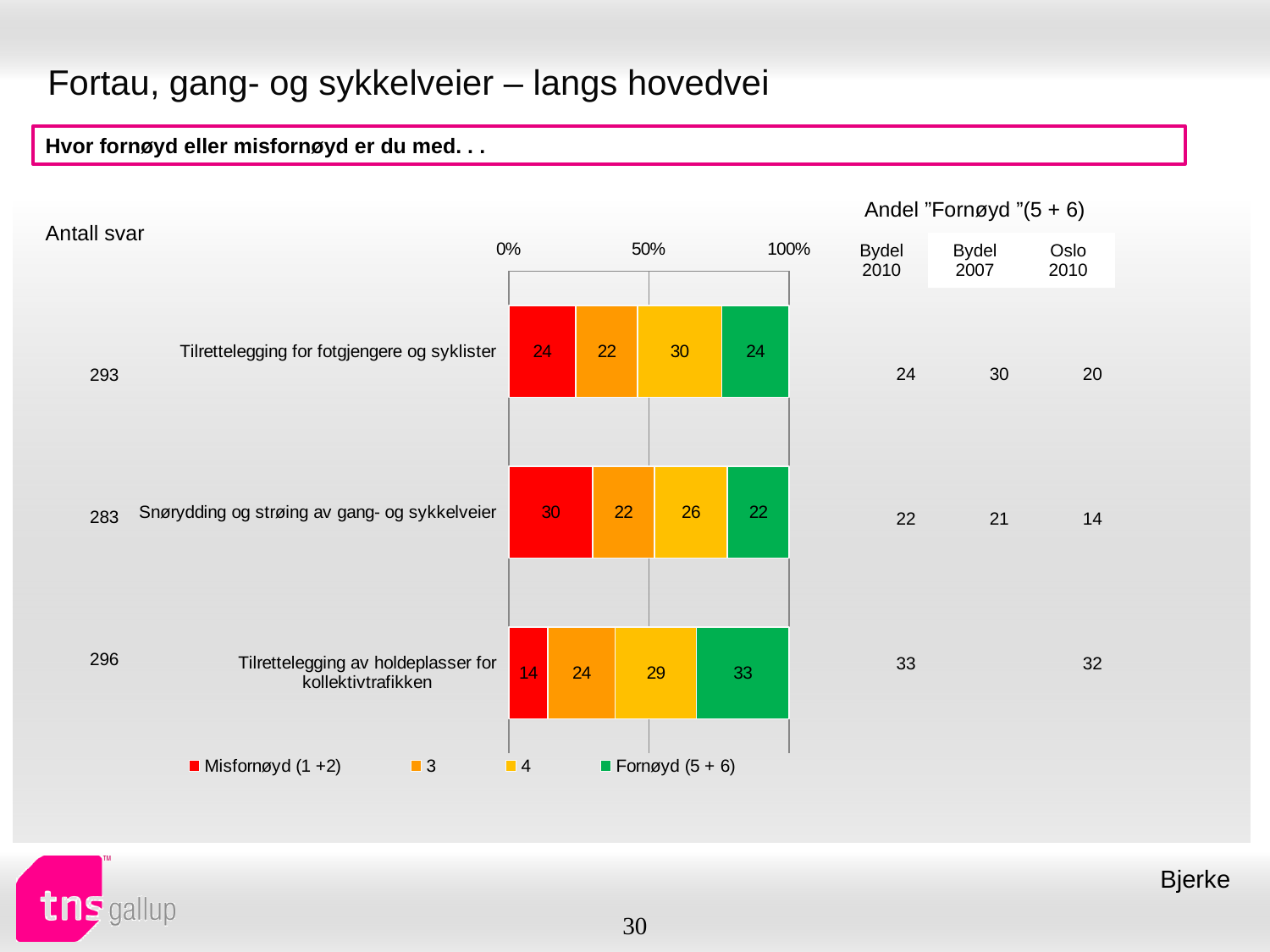
Which category has the highest 'Fornøyd (5 + 6)' value? Tilrettelegging av holdeplasser for kollektivtrafikken What is the difference between the 'Misfornøyd (1 +2)' values for 'Snørydding og strøing av gang- og sykkelveier' and 'Tilrettelegging av holdeplasser for kollektivtrafikken'? 16 How many series does the legend list? 4 What is the value of 'Misfornøyd (1 +2)' for 'Snørydding og strøing av gang- og sykkelveier'? 30 Which category has the lowest 'Misfornøyd (1 +2)' value? Tilrettelegging av holdeplasser for kollektivtrafikken What is the value of series '4' for 'Tilrettelegging for fotgjengere og syklister'? 30 What is the value of 'Fornøyd (5 + 6)' for 'Tilrettelegging av holdeplasser for kollektivtrafikken'? 33 How many categories are plotted in the chart? 3 What kind of chart is shown on the slide? stacked bar chart Which is larger: the 'Fornøyd (5 + 6)' value for 'Tilrettelegging for fotgjengere og syklister' or for 'Tilrettelegging av holdeplasser for kollektivtrafikken'? Tilrettelegging av holdeplasser for kollektivtrafikken What is the total of the stacked bar for 'Snørydding og strøing av gang- og sykkelveier'? 100 What colour represents the 'Fornøyd (5 + 6)' series in the chart? green